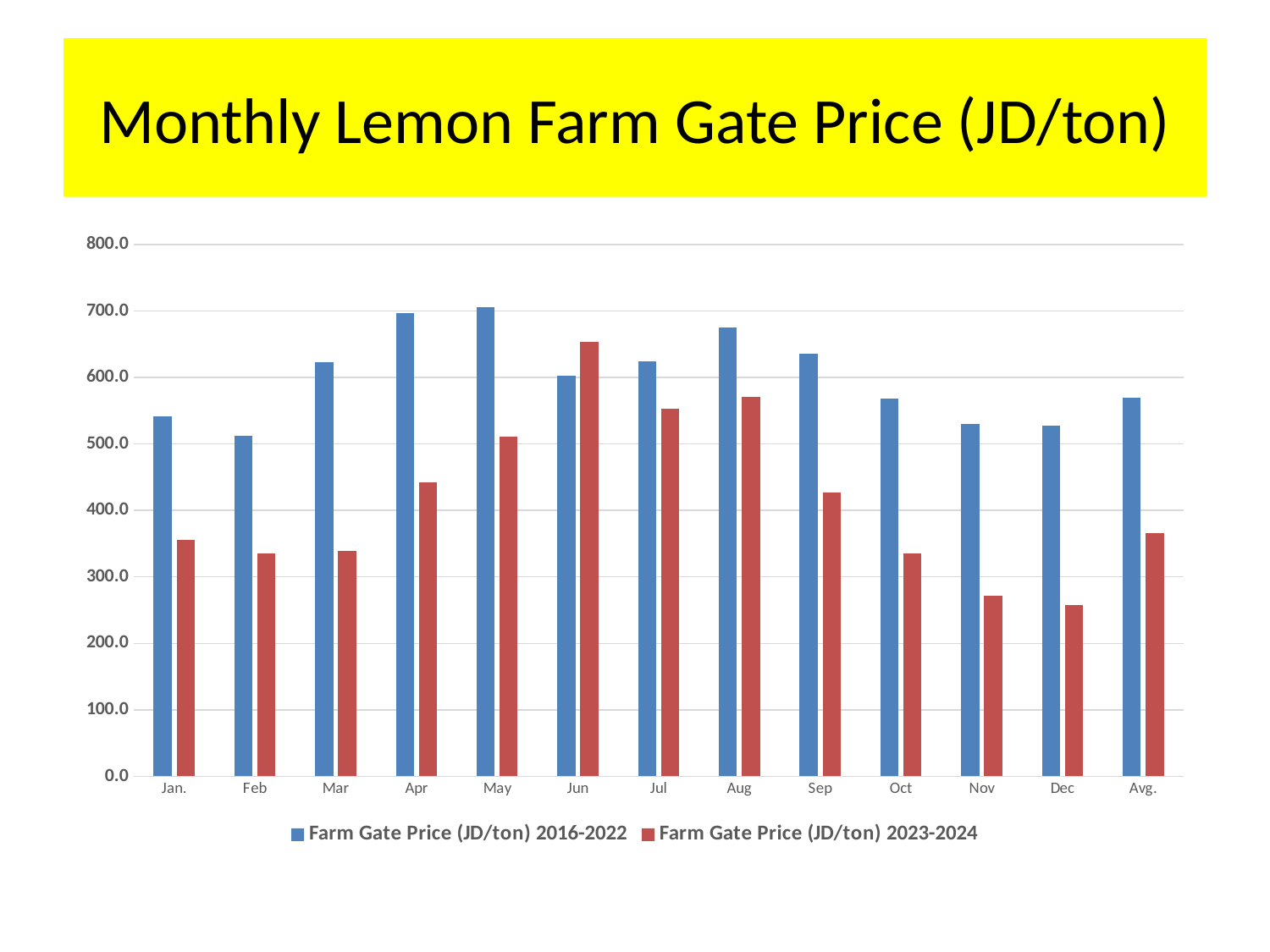
Does the Farm Gate Price (JD/ton) 2023-2024 rise or fall from Jan. to Jun? rise Is the Farm Gate Price (JD/ton) 2023-2024 for Jan. greater or less than 400.0? less In which month is the Farm Gate Price (JD/ton) 2023-2024 highest? Jun Is the Farm Gate Price (JD/ton) 2016-2022 for Apr greater or less than 600.0? greater Is the Avg. Farm Gate Price (JD/ton) 2016-2022 greater or less than 500.0? greater For Jun, which series has the larger value: Farm Gate Price (JD/ton) 2016-2022 or Farm Gate Price (JD/ton) 2023-2024? Farm Gate Price (JD/ton) 2023-2024 What kind of chart is shown on the slide? bar chart How many series does the legend list? 2 What is the title of the chart on the slide? Monthly Lemon Farm Gate Price (JD/ton) How many categories are shown along the x axis? 13